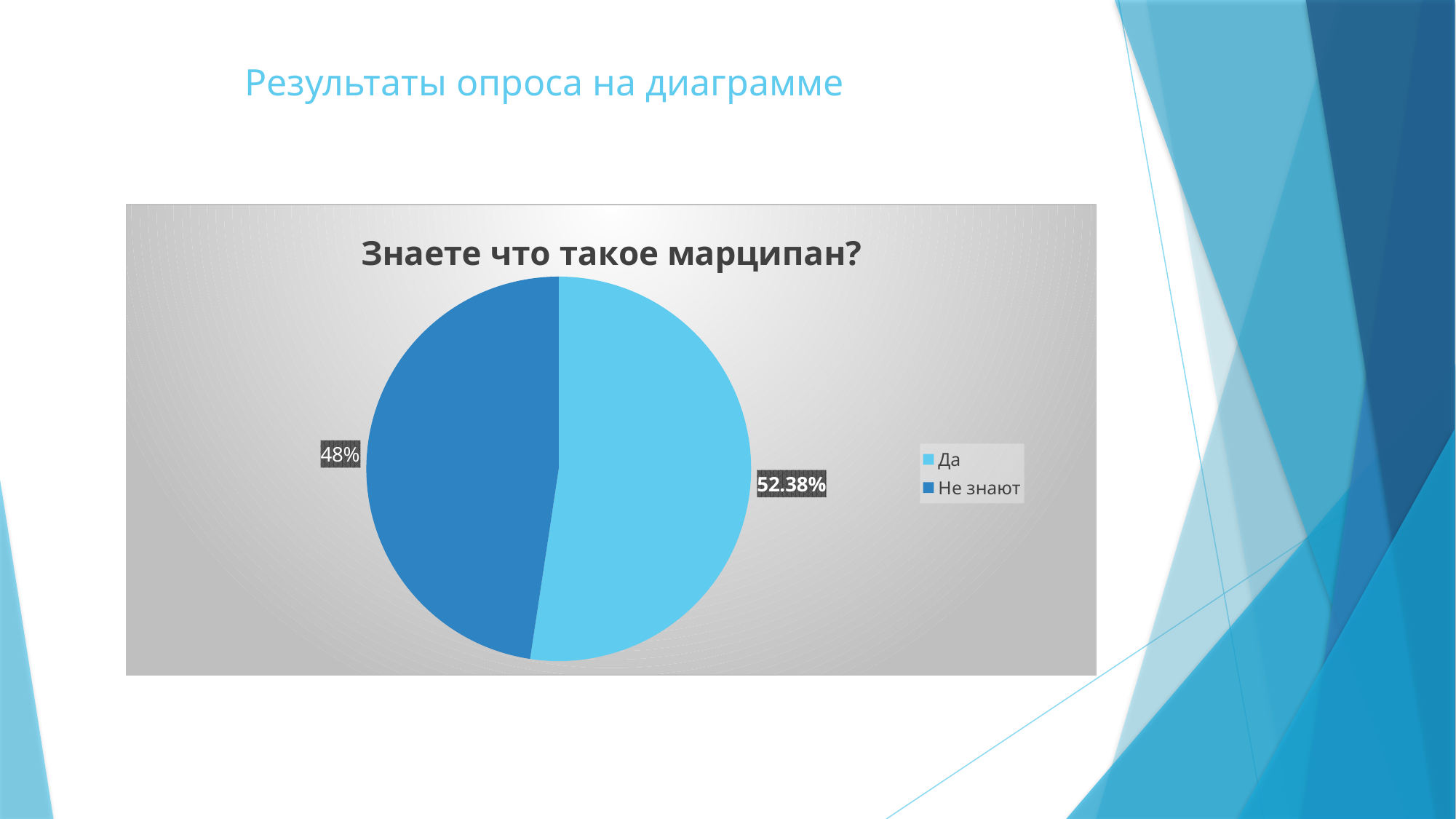
What is the title of the chart? Знаете что такое марципан? What is the difference between the "Да" share and the "Не знают" share? 4.38% Which slice of the pie is the largest? Да Which slice of the pie is the smallest? Не знают What share of the pie does the "Не знают" slice represent? 48% What kind of chart is shown on the slide? Pie chart How many entries does the chart legend list? 2 What share of the pie does the "Да" slice represent? 52.38% Which legend entry is shown in the darker blue colour? Не знают How many slices does the pie chart have? 2 Which is larger, the "Да" slice or the "Не знают" slice? Да